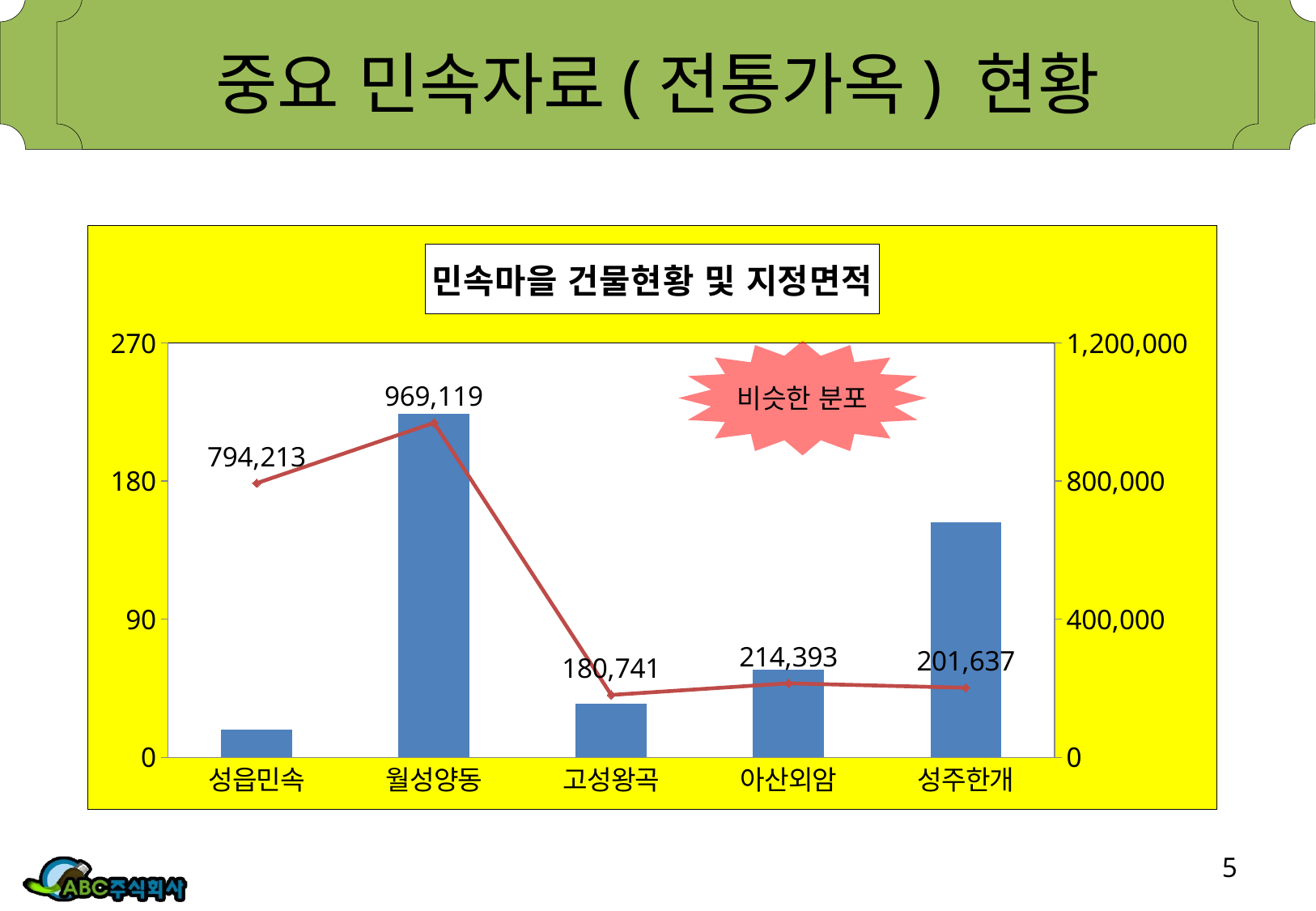
Is the bar value for 월성양동 greater or less than 180 on the left axis? greater What is the difference between the line values for 월성양동 and 성읍민속? 174,906 Which category has the lowest value on the line series? 고성왕곡 Which category has the highest value on the line series? 월성양동 What is the line value shown for 월성양동? 969,119 What kind of chart is this? Combination bar and line chart Which has the larger line value, 아산외암 or 성주한개? 아산외암 Is the bar value for 성읍민속 greater or less than 90 on the left axis? less What is the line value shown for 성읍민속? 794,213 How many categories are shown on the x axis? 5 What is the line value shown for 고성왕곡? 180,741 What is the difference between the line values for 아산외암 and 성주한개? 12,756